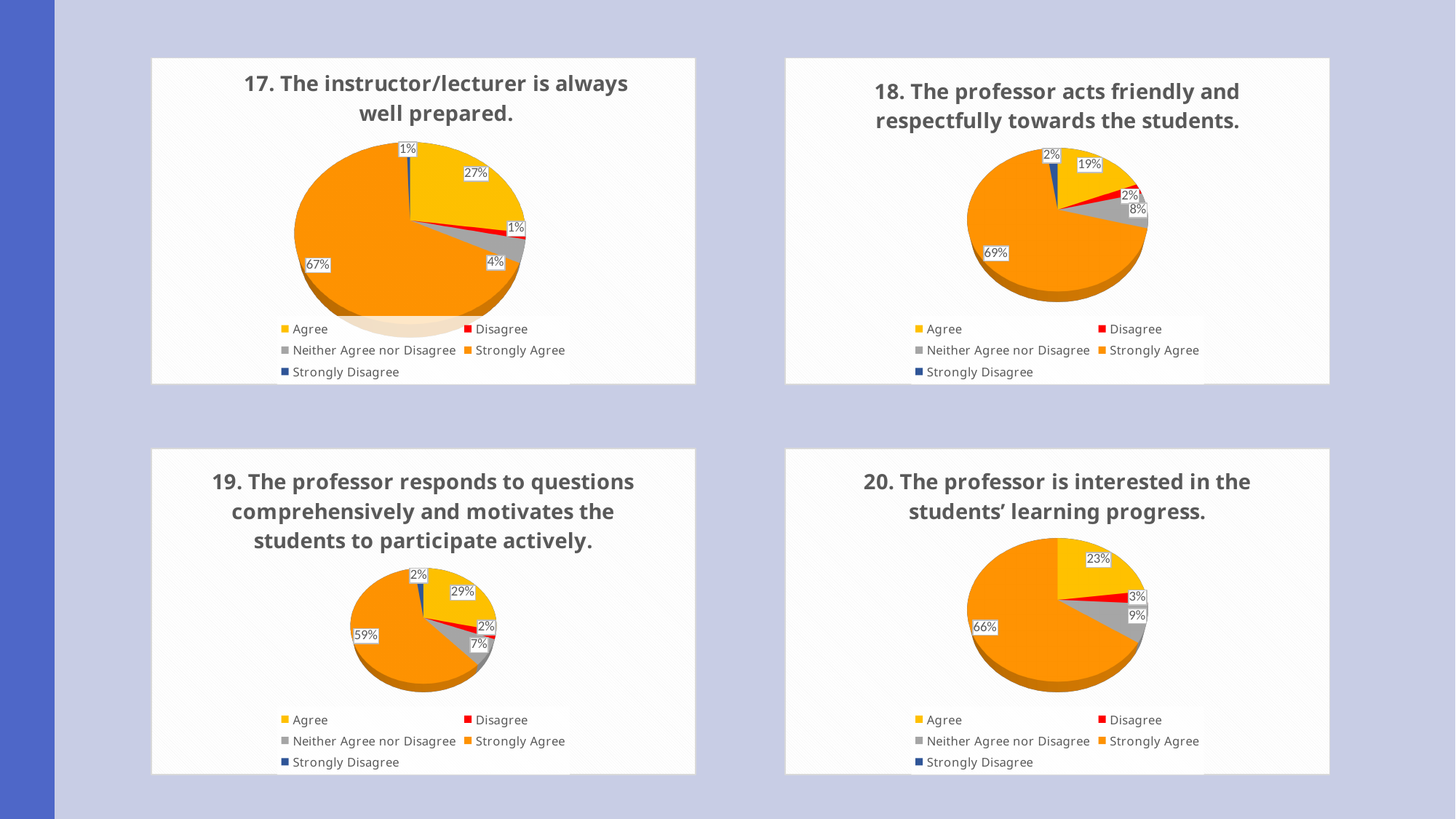
In the chart titled "17. The instructor/lecturer is always well prepared.", what is the value for Neither Agree nor Disagree? 4% In the chart titled "19. The professor responds to questions comprehensively and motivates the students to participate actively.", what is the value for Neither Agree nor Disagree? 7% In the chart titled "20. The professor is interested in the students' learning progress.", what is the value for Agree? 23% In the chart titled "20. The professor is interested in the students' learning progress.", which is larger, Neither Agree nor Disagree or Disagree? Neither Agree nor Disagree In the chart titled "18. The professor acts friendly and respectfully towards the students.", what is the difference between Strongly Agree and Agree? 50% How many entries does the legend list in the chart titled "19. The professor responds to questions comprehensively and motivates the students to participate actively."? 5 In the chart titled "18. The professor acts friendly and respectfully towards the students.", which category has the largest slice? Strongly Agree In the chart titled "18. The professor acts friendly and respectfully towards the students.", what is the value for Agree? 19% In the chart titled "17. The instructor/lecturer is always well prepared.", what share of the pie is Strongly Agree? 67% What kind of chart is used in the chart titled "17. The instructor/lecturer is always well prepared."? Pie chart In the chart titled "17. The instructor/lecturer is always well prepared.", what colour represents Strongly Agree? Orange In the chart titled "19. The professor responds to questions comprehensively and motivates the students to participate actively.", what share of the pie is Strongly Agree? 59%